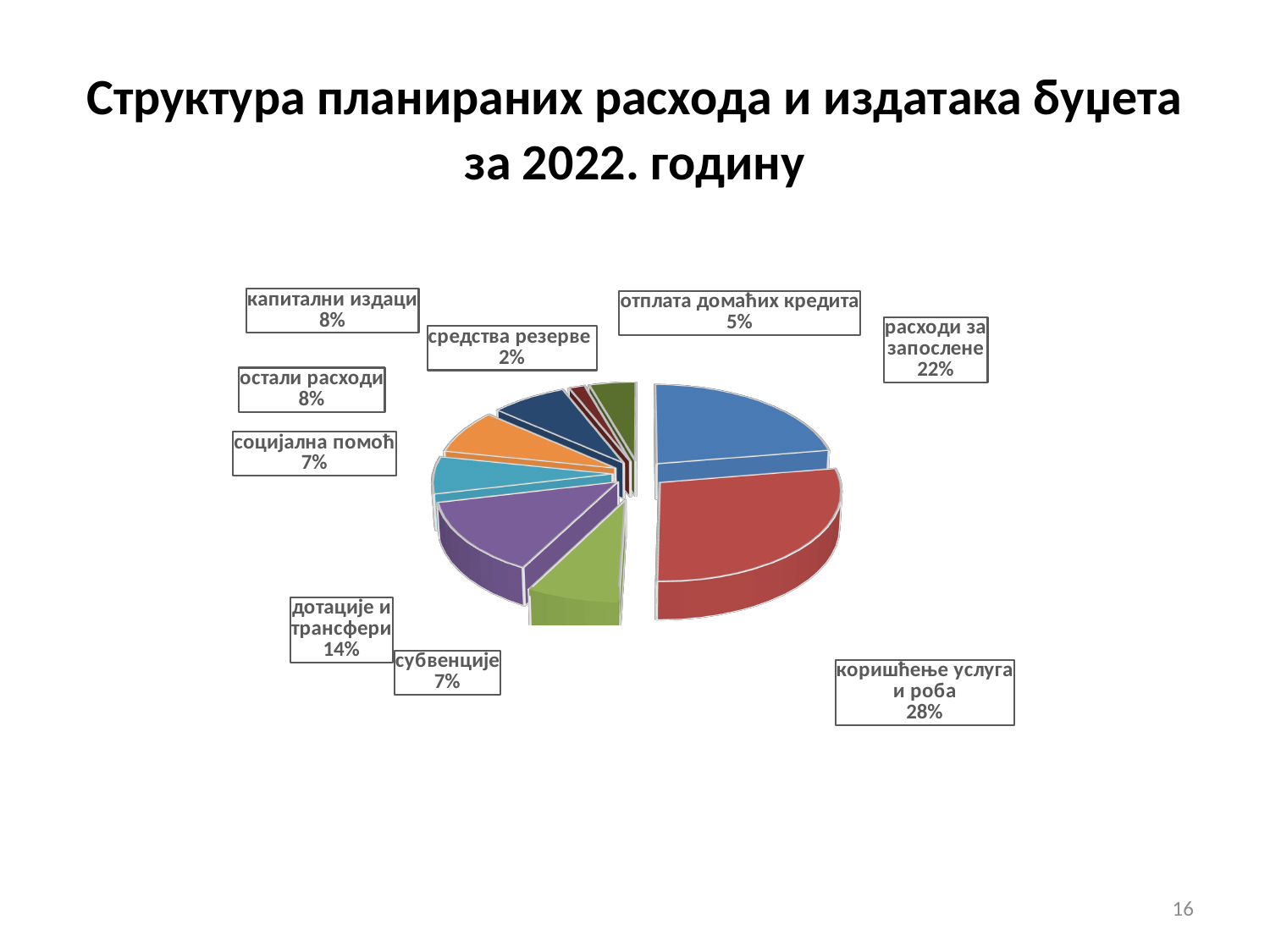
What share of the pie does "дотације и трансфери" have? 14% What share of the pie does "расходи за запослене" have? 22% What share of the pie does "средства резерве" have? 2% What is the difference in percentage points between "коришћење услуга и роба" and "расходи за запослене"? 6 How many categories (slices) does the pie chart have? 9 Which category has the largest share of the pie? коришћење услуга и роба What share of the pie does "коришћење услуга и роба" have? 28% What share of the pie does "отплата домаћих кредита" have? 5% Which category has the smallest share of the pie? средства резерве Which is larger, the share for "дотације и трансфери" or the share for "капитални издаци"? дотације и трансфери What is the title of the slide containing the chart? Структура планираних расхода и издатака буџета за 2022. годину What kind of chart is shown on the slide? pie chart